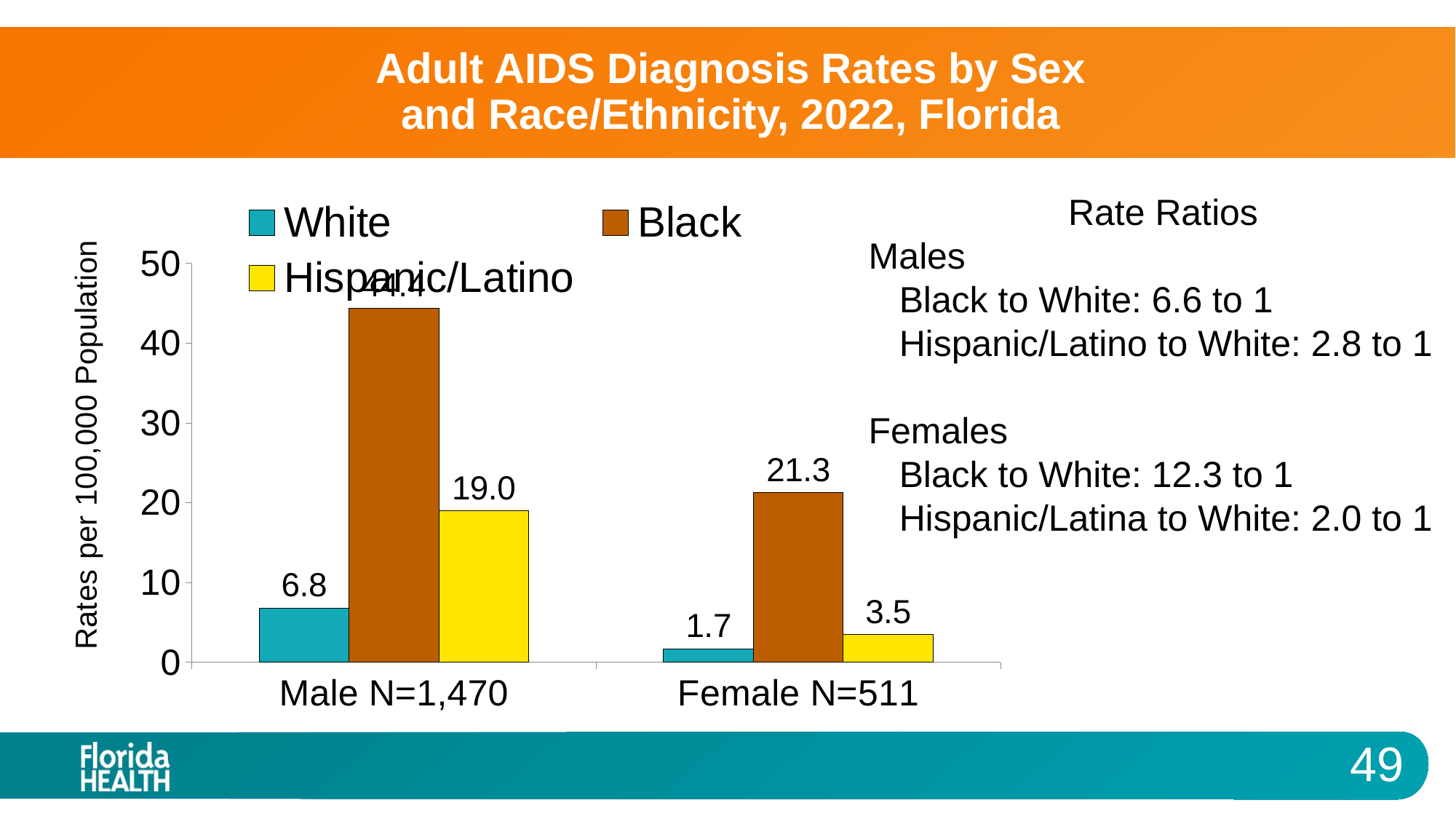
What is the AIDS diagnosis rate for Black females? 21.3 How many series does the legend list? 3 What type of chart is shown on the slide? Bar chart Which race/ethnicity group has the lowest rate among males? White Which race/ethnicity group has the highest rate among females? Black What is the AIDS diagnosis rate for White females? 1.7 What is the AIDS diagnosis rate for Hispanic/Latino males? 19.0 Is the rate for Black males greater or less than 40? greater What is the AIDS diagnosis rate for White males? 6.8 What is the difference between the Black female rate and the White female rate? 19.6 What is the AIDS diagnosis rate for Hispanic/Latino females? 3.5 Which is larger, the Hispanic/Latino male rate or the Black female rate? Black female rate